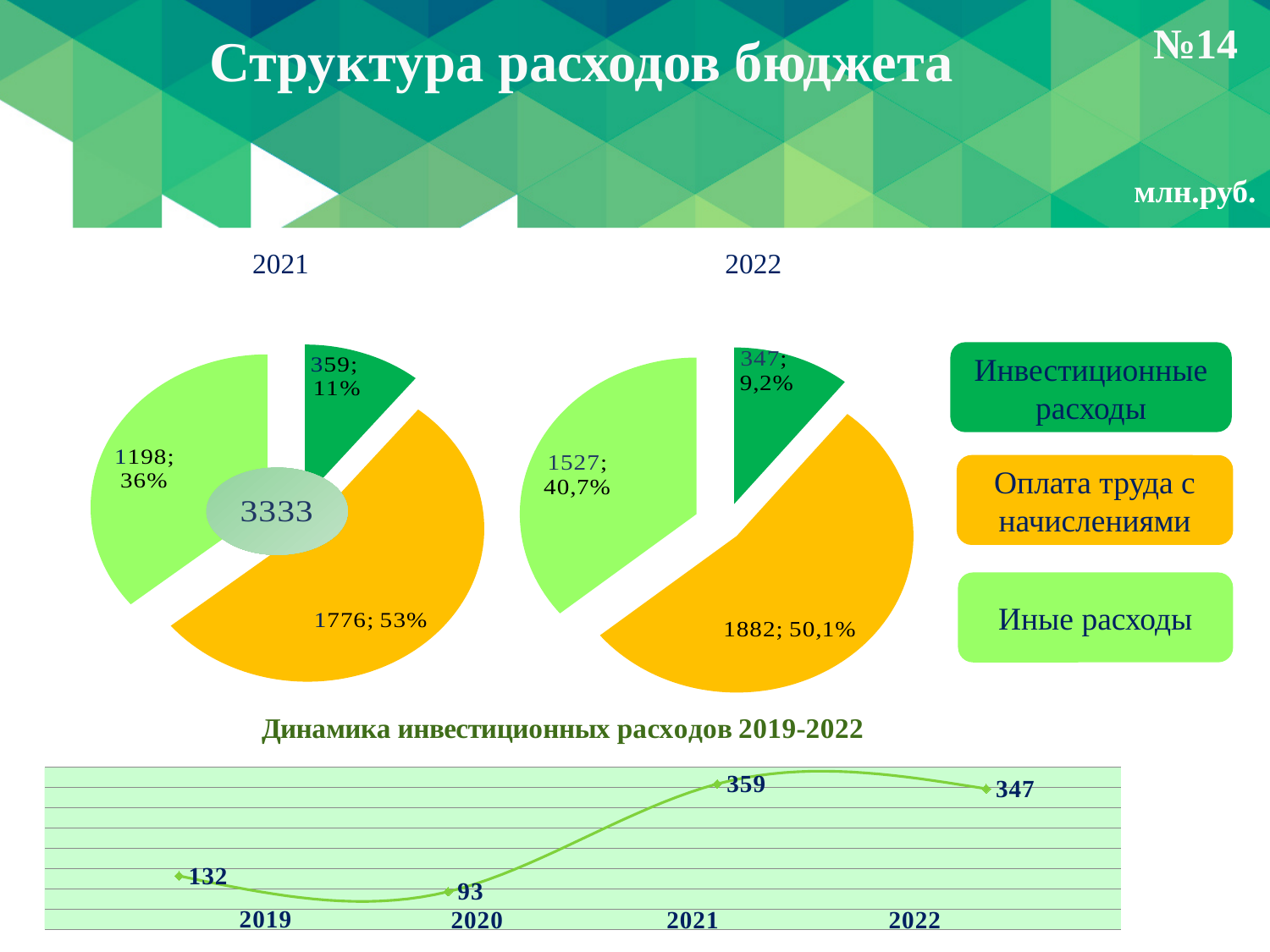
In the 2021 pie chart, which category is the largest? Оплата труда с начислениями In the 2021 pie chart, what is the difference between Оплата труда с начислениями and Иные расходы? 578 In the 2022 pie chart, what is the value for Инвестиционные расходы? 347; 9,2% In the 2021 pie chart, what is the value for Оплата труда с начислениями? 1776; 53% In the chart Динамика инвестиционных расходов 2019-2022, what is the difference between 2021 and 2022? 12 In the 2022 pie chart, which category is the smallest? Инвестиционные расходы In the chart Динамика инвестиционных расходов 2019-2022, which year has the highest value? 2021 In the chart Динамика инвестиционных расходов 2019-2022, what is the value for 2020? 93 What kind of chart is Динамика инвестиционных расходов 2019-2022? line chart In the 2022 pie chart, what share do Иные расходы have? 40,7% How many categories does the legend next to the pie charts list? 3 In the 2021 pie chart, what total is shown in the centre? 3333